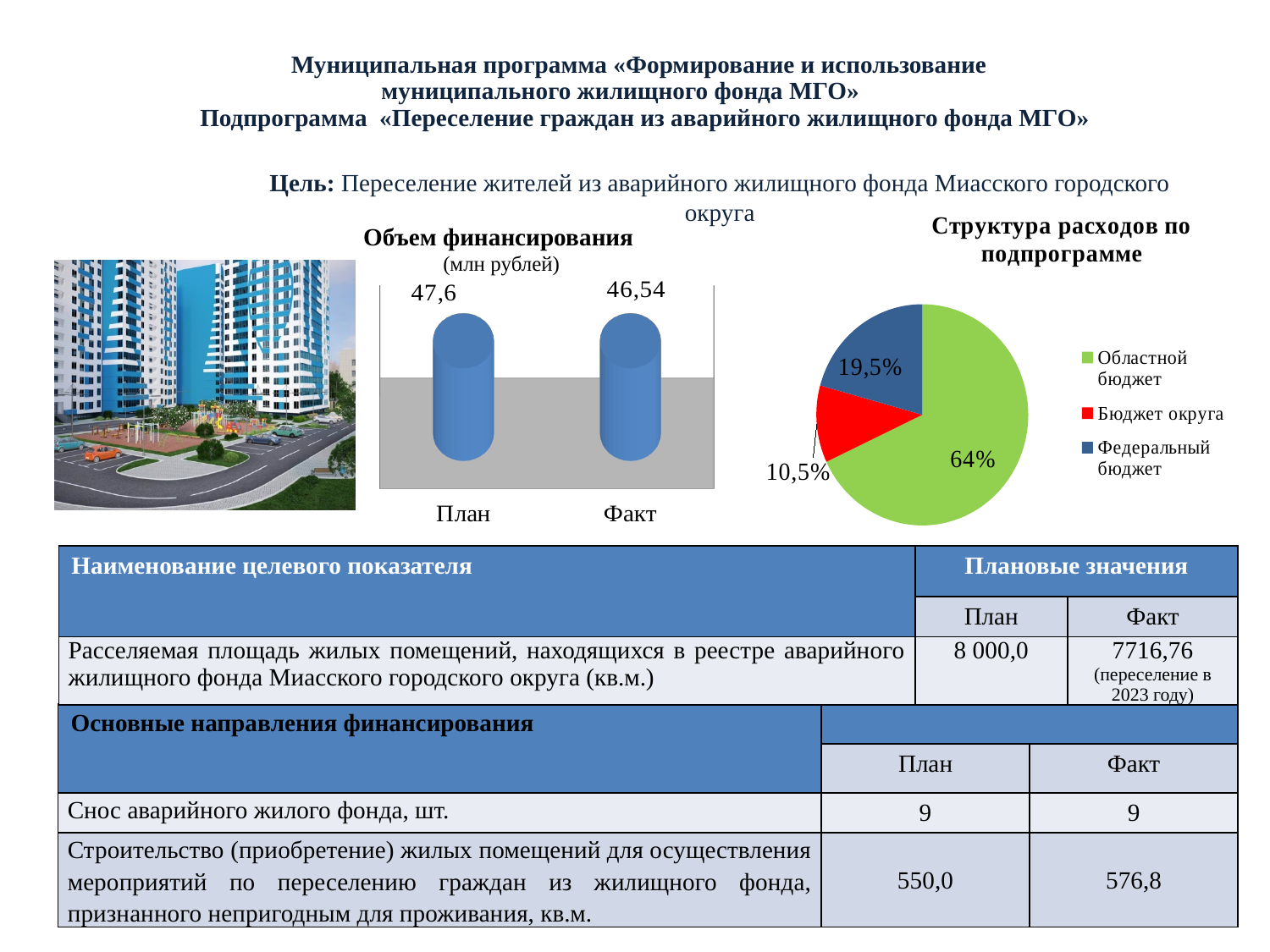
In the 'Объем финансирования' bar chart, which category has the higher value, План or Факт? План In the 'Структура расходов по подпрограмме' pie chart, which slice is the largest? Областной бюджет In the 'Объем финансирования' bar chart, what is the value for Факт? 46,54 In the 'Объем финансирования' bar chart, what unit is given under the title? млн рублей In the 'Структура расходов по подпрограмме' pie chart, what share does Федеральный бюджет have? 19,5% In the 'Структура расходов по подпрограмме' pie chart, which slice is the smallest? Бюджет округа In the 'Объем финансирования' bar chart, what is the value for План? 47,6 In the 'Объем финансирования' bar chart, what is the difference between the План and Факт values? 1,06 In the 'Объем финансирования' bar chart, how many bars are plotted? 2 In the 'Структура расходов по подпрограмме' pie chart, what share does Областной бюджет have? 64% How many entries does the legend of the 'Структура расходов по подпрограмме' pie chart list? 3 What kind of chart is 'Объем финансирования'? Bar chart